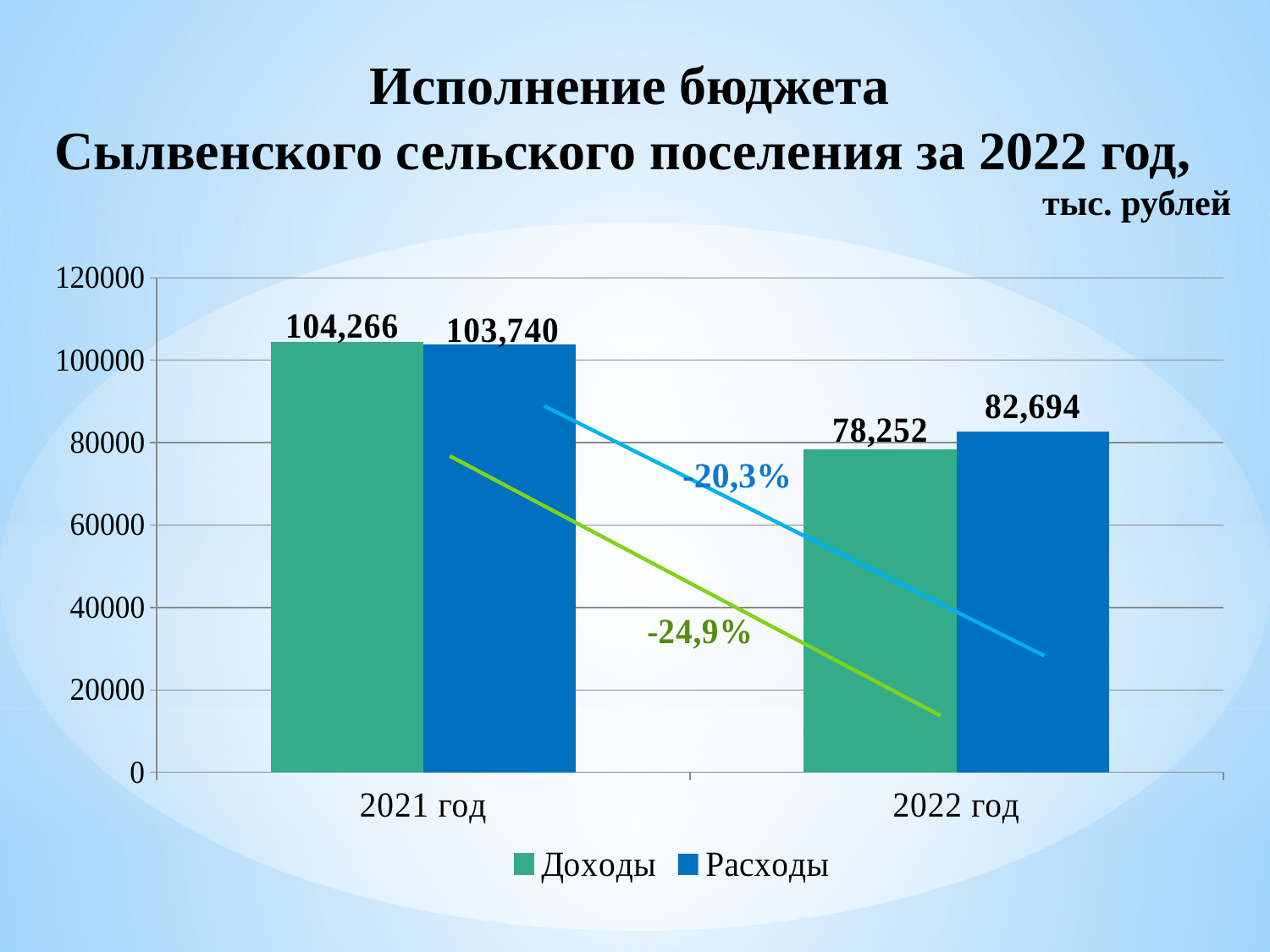
In 2022 год, which is larger: Доходы or Расходы? Расходы What percentage change is shown for Доходы from 2021 год to 2022 год? -24,9% What is the value for Расходы in 2021 год? 103,740 Which bar on the chart has the lowest value? Доходы, 2022 год How many series does the legend list? 2 What is the difference between Расходы and Доходы in 2022 год? 4,442 What kind of chart is shown on the slide? Bar chart What is the value for Доходы in 2021 год? 104,266 What is the value for Расходы in 2022 год? 82,694 What is the value for Доходы in 2022 год? 78,252 Which year has the higher value for Доходы? 2021 год What is the difference between Доходы in 2021 год and Доходы in 2022 год? 26,014